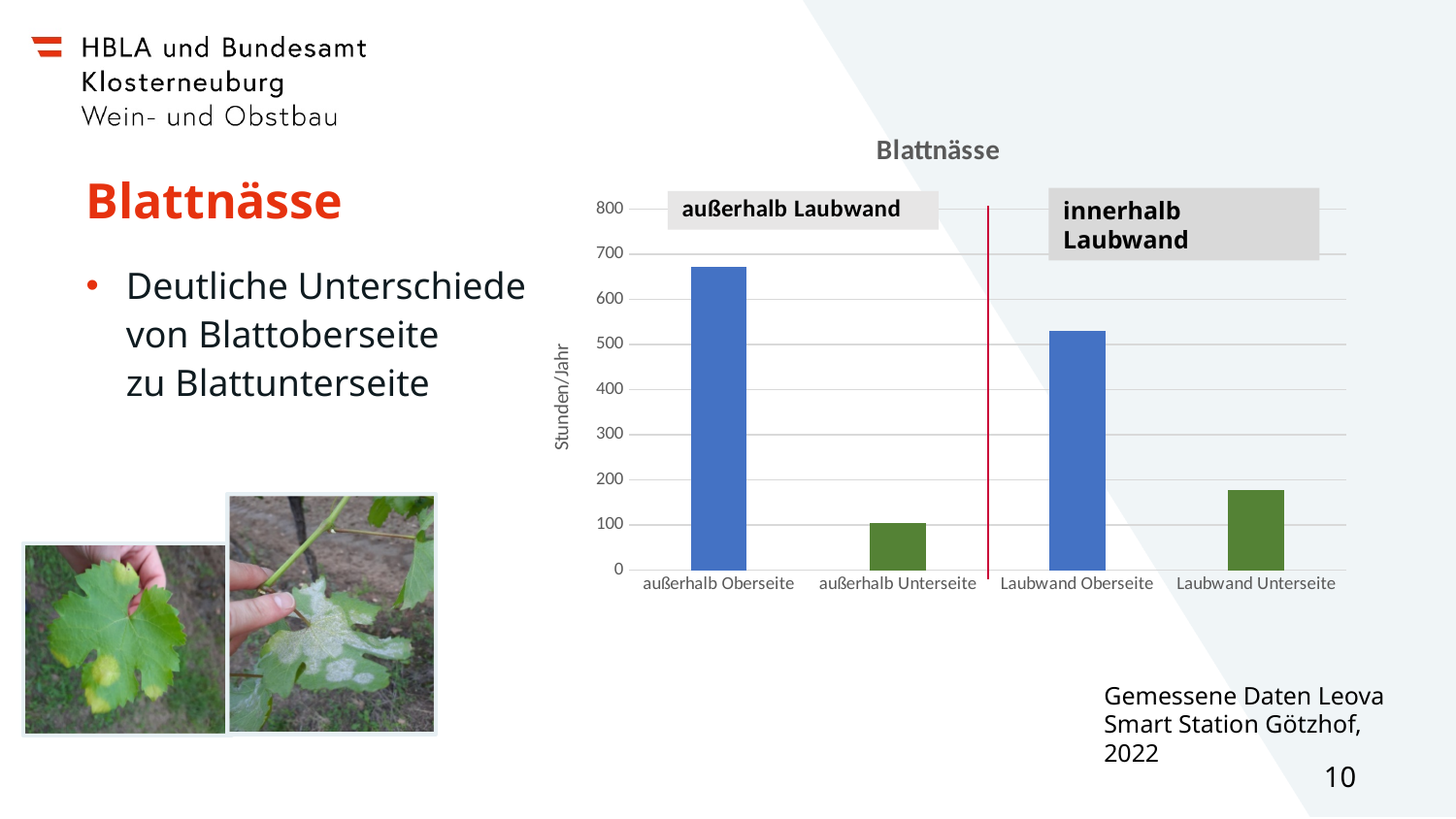
How many categories are plotted in the Blattnässe chart? 4 Is the value for außerhalb Oberseite greater or less than 600? greater Is the value for Laubwand Oberseite greater or less than 500? greater What is the label on the vertical axis of the chart? Stunden/Jahr What is the title of the chart? Blattnässe Is the value for Laubwand Unterseite greater or less than 300? less Which category has the highest value in the Blattnässe chart? außerhalb Oberseite Which is larger, the value for außerhalb Unterseite or the value for Laubwand Unterseite? Laubwand Unterseite Which is larger, the value for außerhalb Oberseite or the value for Laubwand Oberseite? außerhalb Oberseite What kind of chart is shown on the slide? bar chart Which category has the lowest value in the Blattnässe chart? außerhalb Unterseite